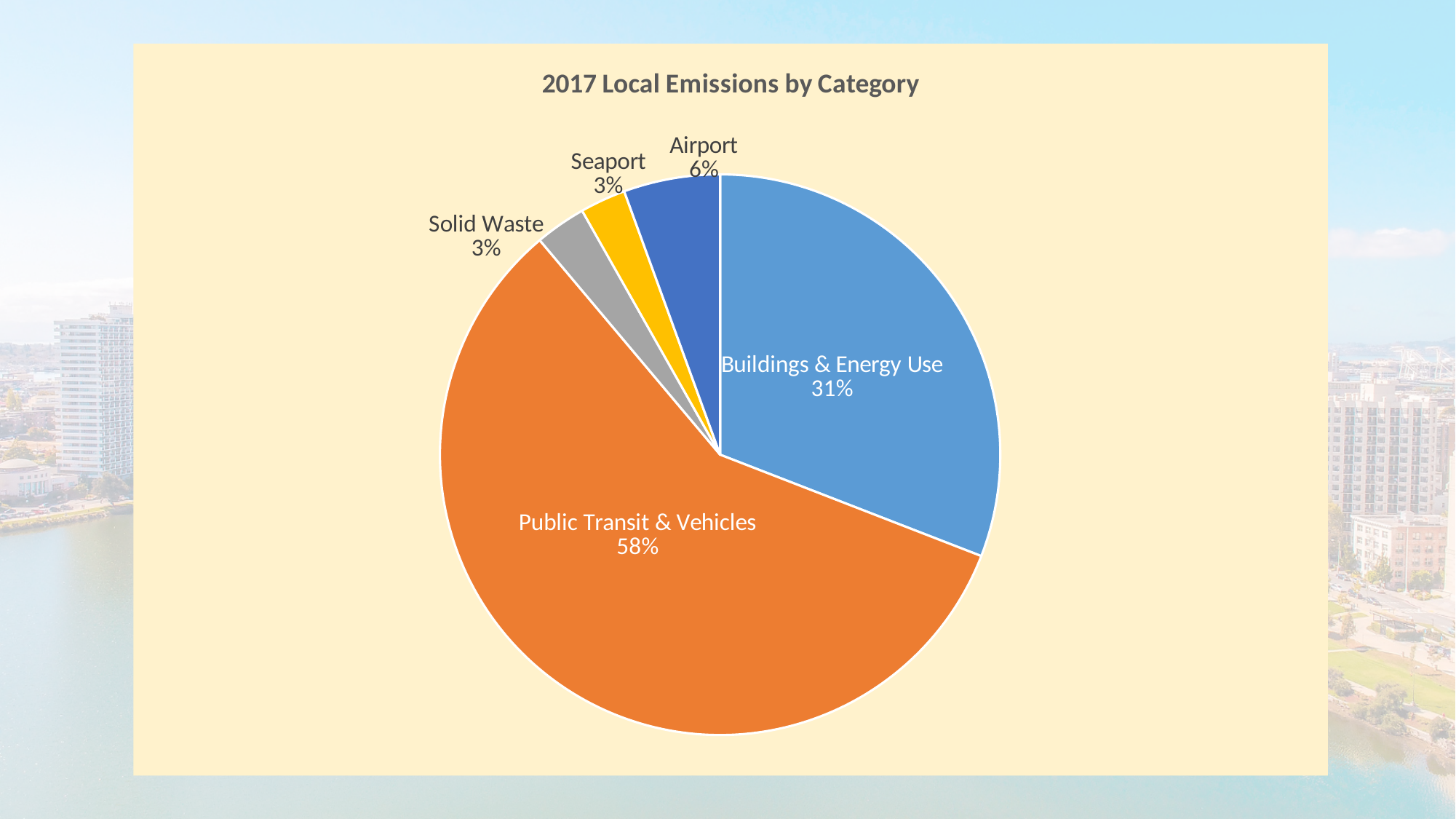
What kind of chart is shown on the slide? Pie chart What is the title of the chart? 2017 Local Emissions by Category How many categories are shown in the pie chart? 5 What percentage of emissions is attributed to the Airport? 6% What share of 2017 local emissions comes from Buildings & Energy Use? 31% What percentage of emissions is attributed to Solid Waste? 3% What percentage of emissions is attributed to the Seaport? 3% Which category accounts for the largest share of 2017 local emissions? Public Transit & Vehicles What colour is the Public Transit & Vehicles slice? Orange Which is larger, the Airport share or the Seaport share? Airport What share of 2017 local emissions comes from Public Transit & Vehicles? 58% What is the difference in percentage points between Public Transit & Vehicles and Buildings & Energy Use? 27